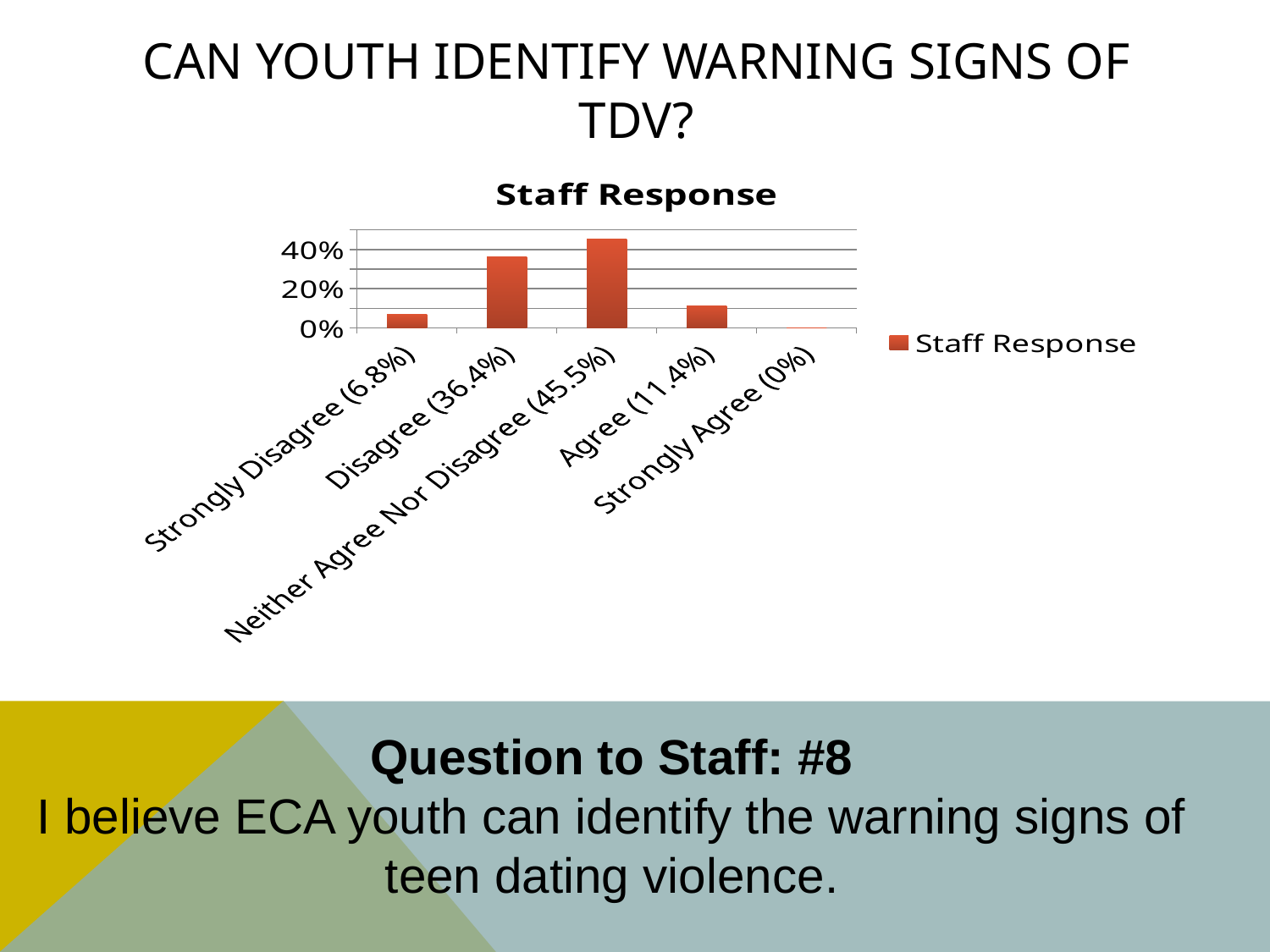
Which response category has the lowest Staff Response value? Strongly Agree What is the Staff Response value for Disagree? 36.4% What is the Staff Response value for Neither Agree Nor Disagree? 45.5% What is the difference between the Staff Response values for Neither Agree Nor Disagree and Disagree? 9.1% Is the Staff Response value for Disagree greater or less than 20%? greater How many response categories are shown on the x axis of the chart? 5 What kind of chart is shown on the slide? Bar chart Which is larger, the Staff Response value for Agree or for Strongly Disagree? Agree How many series does the chart legend list? 1 Which response category has the highest Staff Response value? Neither Agree Nor Disagree What is the difference between the Staff Response values for Agree and Strongly Disagree? 4.6% What is the Staff Response value for Strongly Agree? 0%